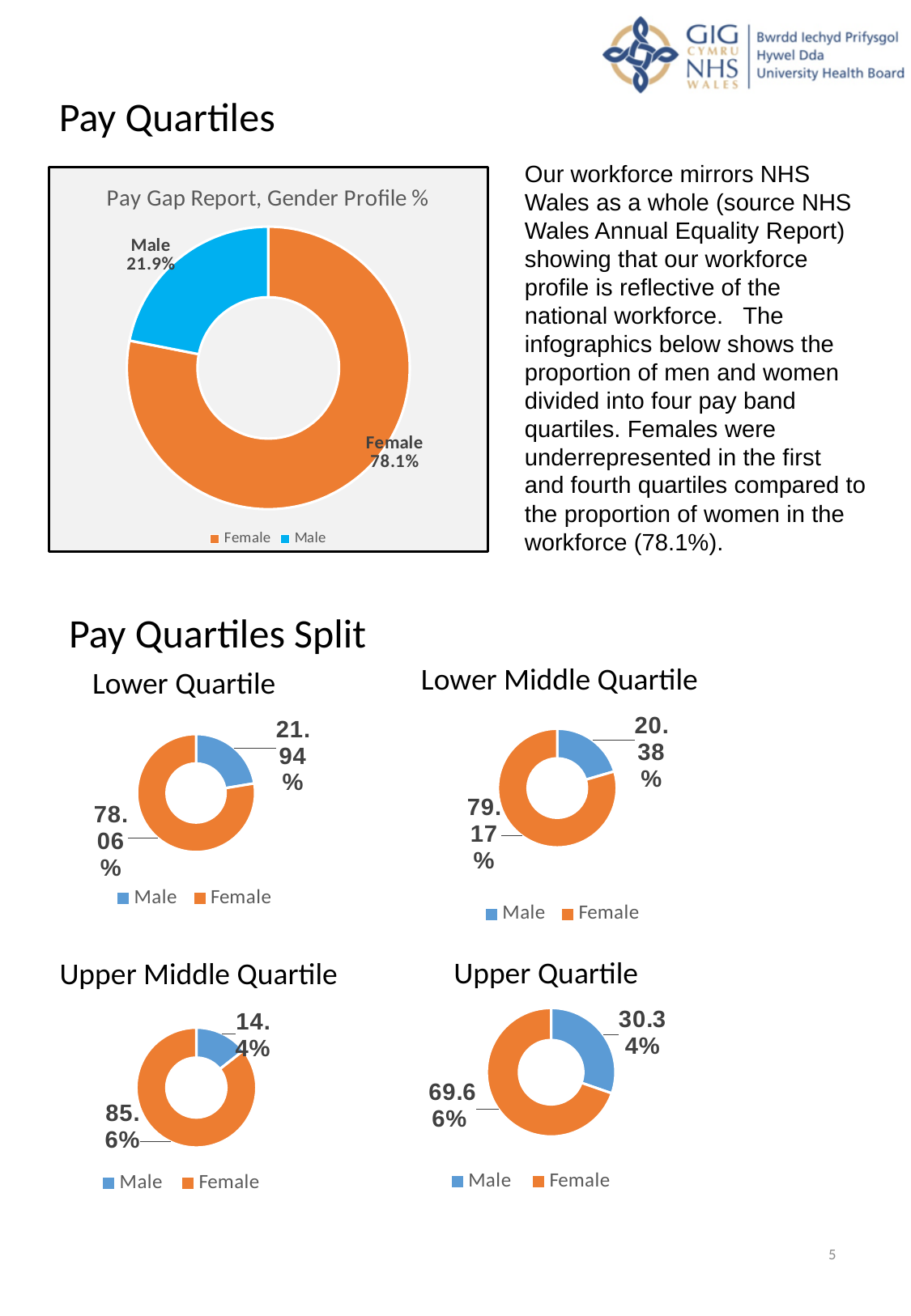
In the 'Pay Gap Report, Gender Profile %' chart, what percentage is shown for Male? 21.9% In the 'Upper Quartile' chart, what percentage is shown for Male? 30.34% In the 'Upper Middle Quartile' chart, which category has the larger share, Male or Female? Female In the 'Lower Quartile' chart, what percentage is shown for Male? 21.94% In the 'Lower Quartile' chart, what percentage is shown for Female? 78.06% What type of chart is the 'Pay Gap Report, Gender Profile %' chart? Doughnut chart In the 'Pay Gap Report, Gender Profile %' chart, what percentage is shown for Female? 78.1% In the 'Upper Middle Quartile' chart, what percentage is shown for Male? 14.4% In the 'Lower Middle Quartile' chart, what percentage is shown for Female? 79.17% In the 'Pay Gap Report, Gender Profile %' chart, what is the difference between the Female and Male percentages? 56.2% In the 'Upper Quartile' chart, what percentage is shown for Female? 69.66% How many entries does the legend of the 'Lower Quartile' chart list? 2